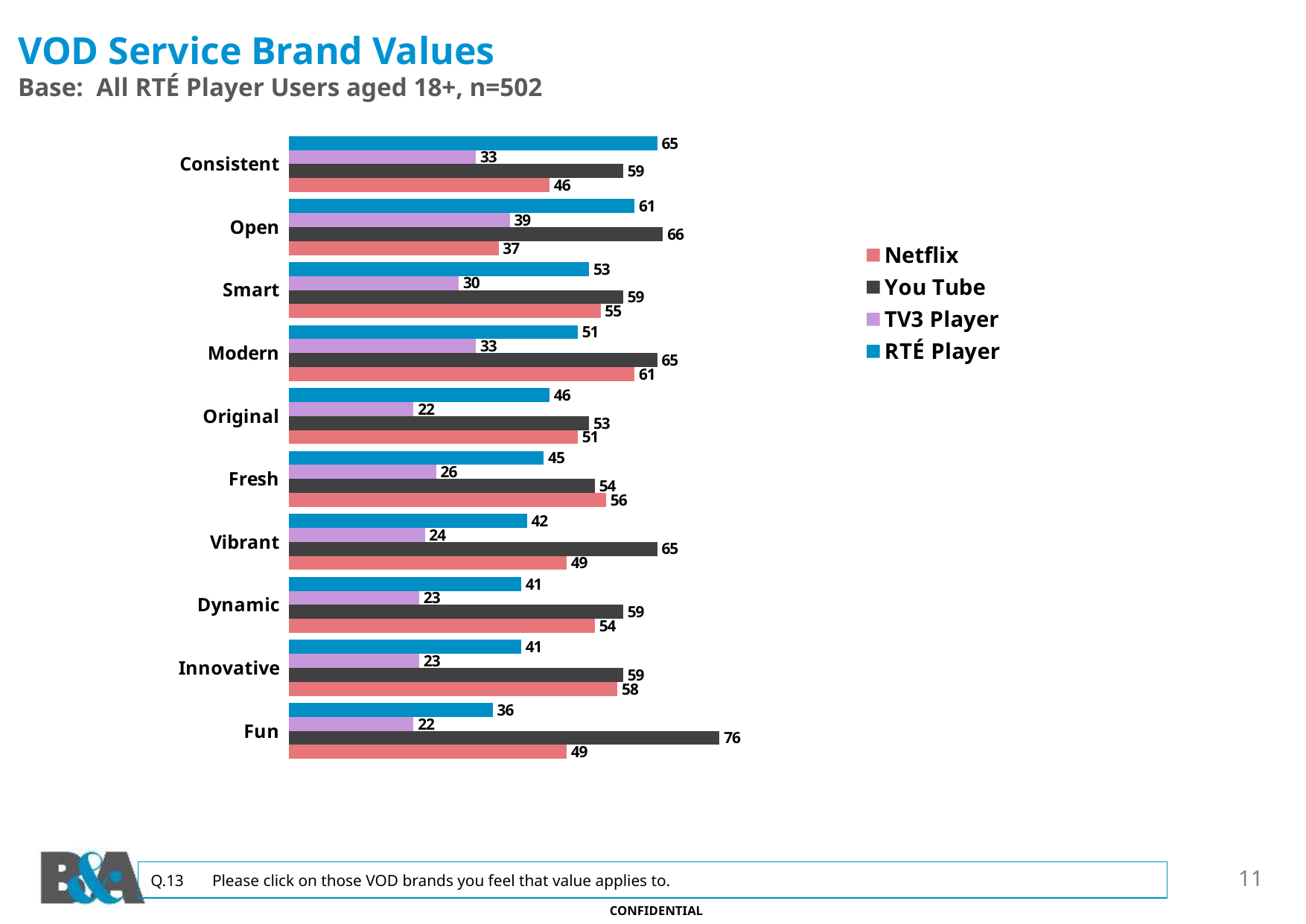
What is the value for TV3 Player on the Open attribute? 39 What is the value for You Tube on the Fun attribute? 76 For which attribute does Netflix have its highest value? Modern What is the value for RTÉ Player on the Consistent attribute? 65 What is the value for Netflix on the Fresh attribute? 56 On the Consistent attribute, what is the difference between the RTÉ Player value and the TV3 Player value? 32 For which attribute does You Tube have its highest value? Fun How many series does the legend list? 4 On the Open attribute, which is larger: the RTÉ Player value or the You Tube value? You Tube For which attribute does RTÉ Player have its lowest value? Fun For which attribute does RTÉ Player have its highest value? Consistent How many brand value attributes are shown on the chart? 10